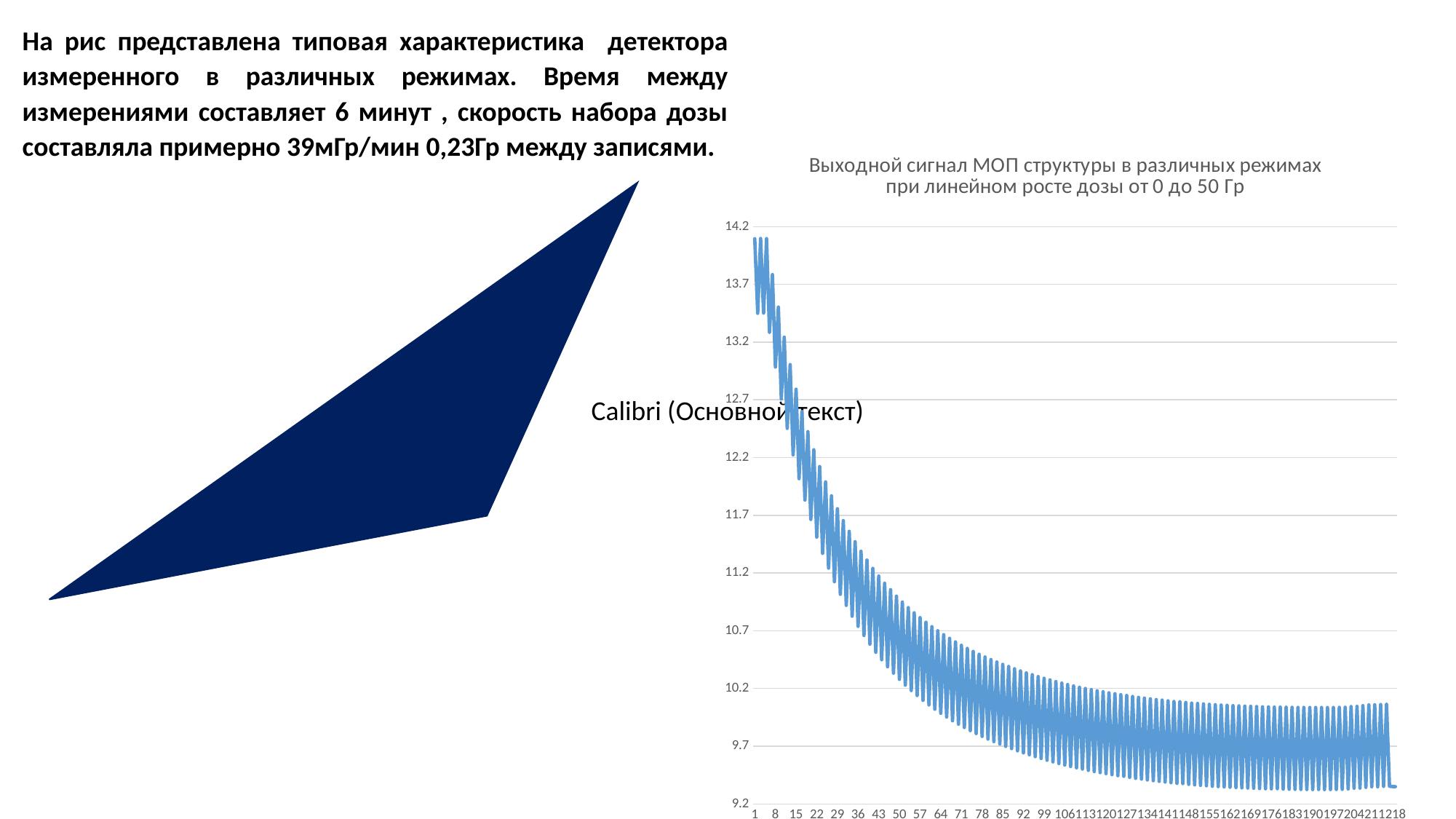
Are the values around x = 8 greater or less than 12.7? greater Are the values around x = 50 greater or less than 12.2? less What is the highest value shown on the y axis? 14.2 Is the value at the first point (x = 1) greater or less than 13.7? greater What kind of chart is shown on the slide? line chart What is the lowest value shown on the y axis? 9.2 Do the values in the chart generally rise or fall along the x axis? fall Is the value at x = 1 greater or less than the value at x = 218? greater What is the title of the chart? Выходной сигнал МОП структуры в различных режимах при линейном росте дозы от 0 до 50 Гр